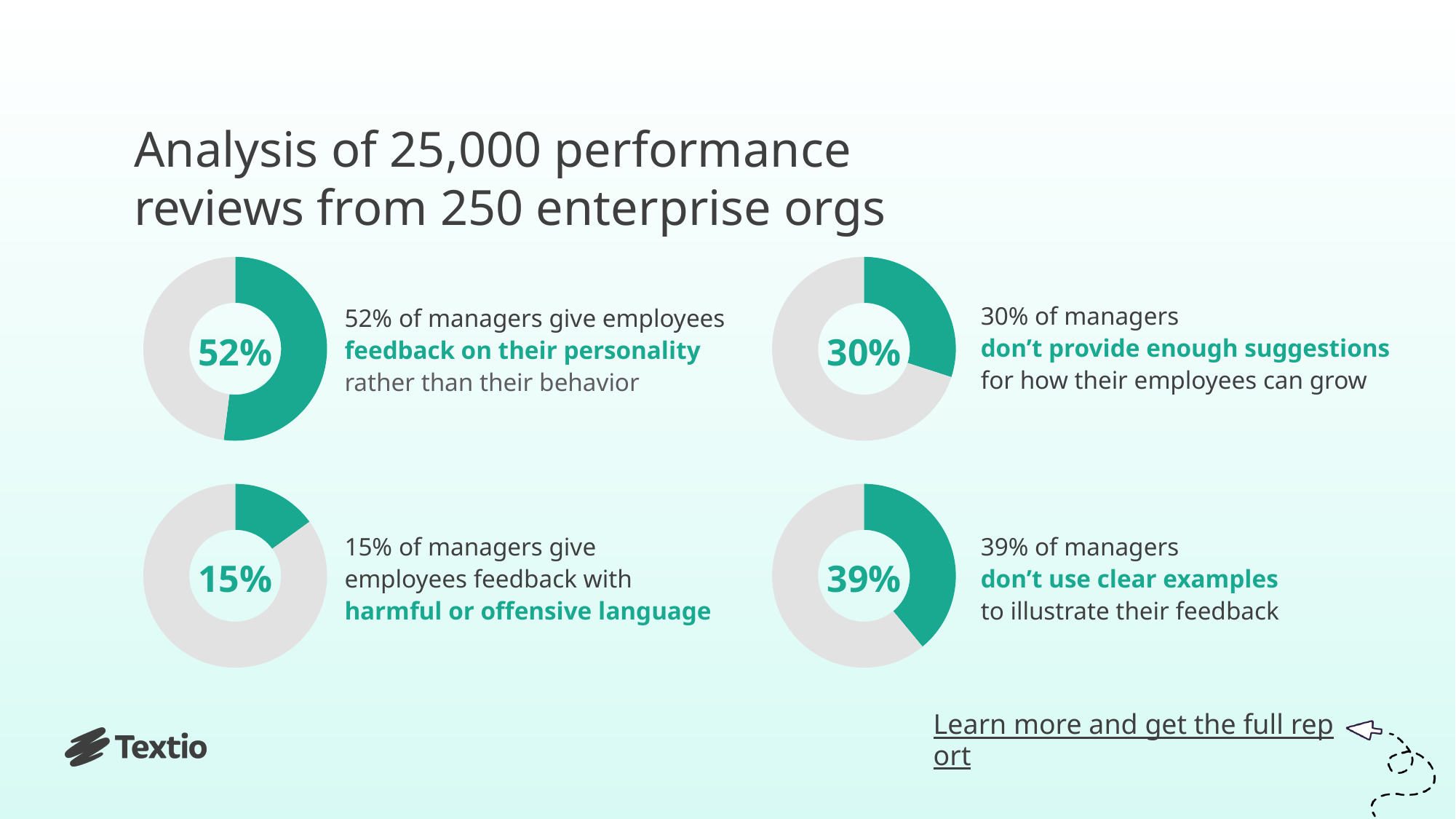
Which is larger: the percentage of managers who don't provide enough suggestions or the percentage who don't use clear examples? Don't use clear examples (39%) What percentage of managers don't use clear examples to illustrate their feedback? 39% How many donut charts are on the slide? 4 What percentage is shown in the bottom-left donut chart? 15% What percentage is shown in the bottom-right donut chart? 39% What percentage is shown in the top-right donut chart? 30% What percentage of managers give employees feedback with harmful or offensive language? 15% Which of the four donut charts shows the lowest percentage? The bottom-left chart (15%, harmful or offensive language) Which of the four donut charts shows the highest percentage? The top-left chart (52%, feedback on their personality) What is the difference between the percentage of managers who give feedback on personality and the percentage who don't use clear examples? 13 percentage points What type of chart is used to display the percentages on the slide? Donut chart What percentage is shown in the top-left donut chart? 52%